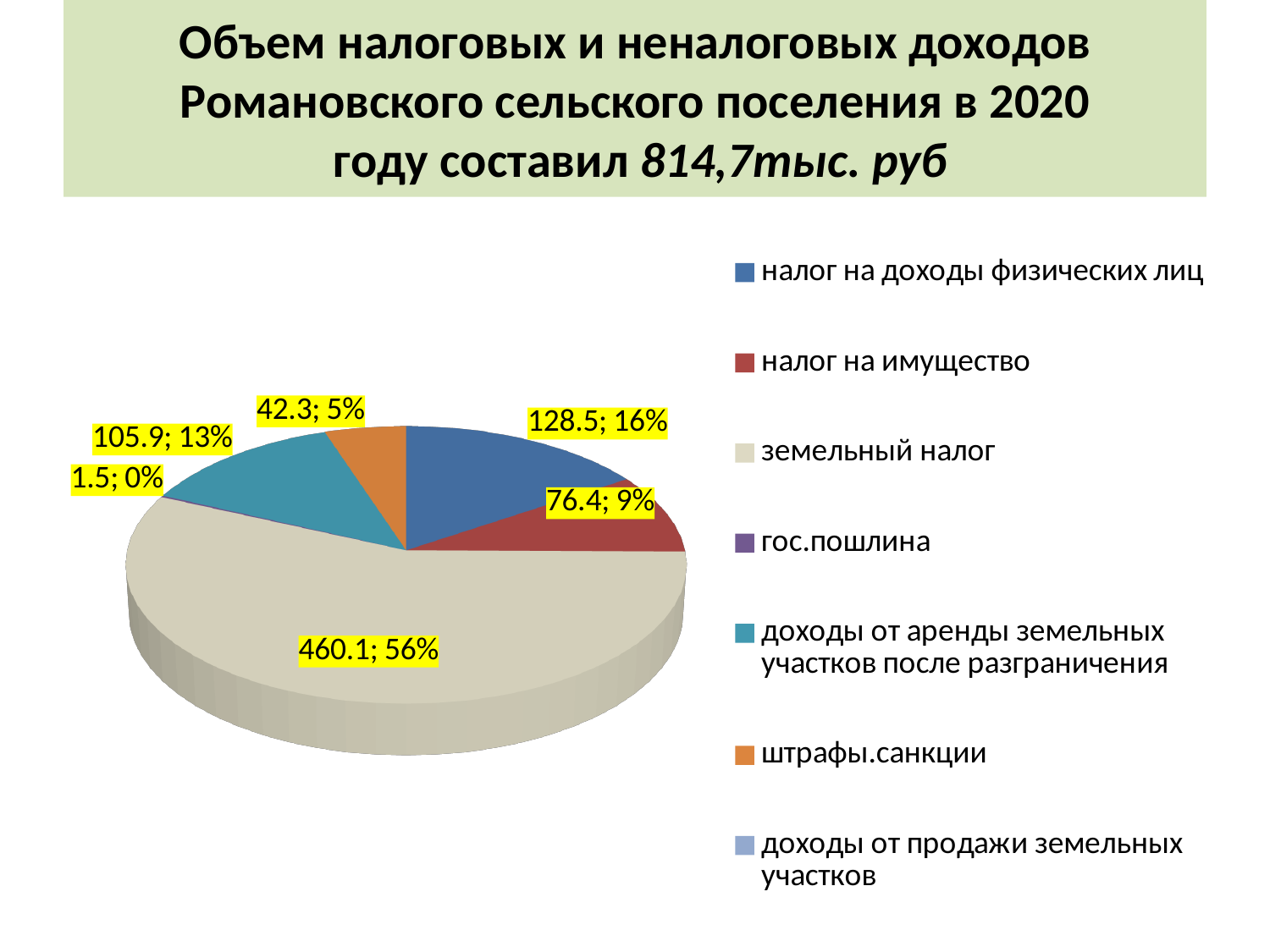
Which category has the largest slice of the pie? земельный налог What value is shown for налог на доходы физических лиц? 128.5 What value is shown for земельный налог on the pie chart? 460.1 What value is shown for штрафы.санкции? 42.3 What is the difference between the values for налог на доходы физических лиц and налог на имущество? 52.1 What kind of chart is shown on the slide? pie chart How many entries does the legend list? 7 Which is larger: доходы от аренды земельных участков после разграничения or штрафы.санкции? доходы от аренды земельных участков после разграничения What share of the pie does земельный налог represent? 56% What value is shown for доходы от аренды земельных участков после разграничения? 105.9 What share of the pie does налог на имущество represent? 9% Which labelled category has the smallest value on the pie chart? гос.пошлина